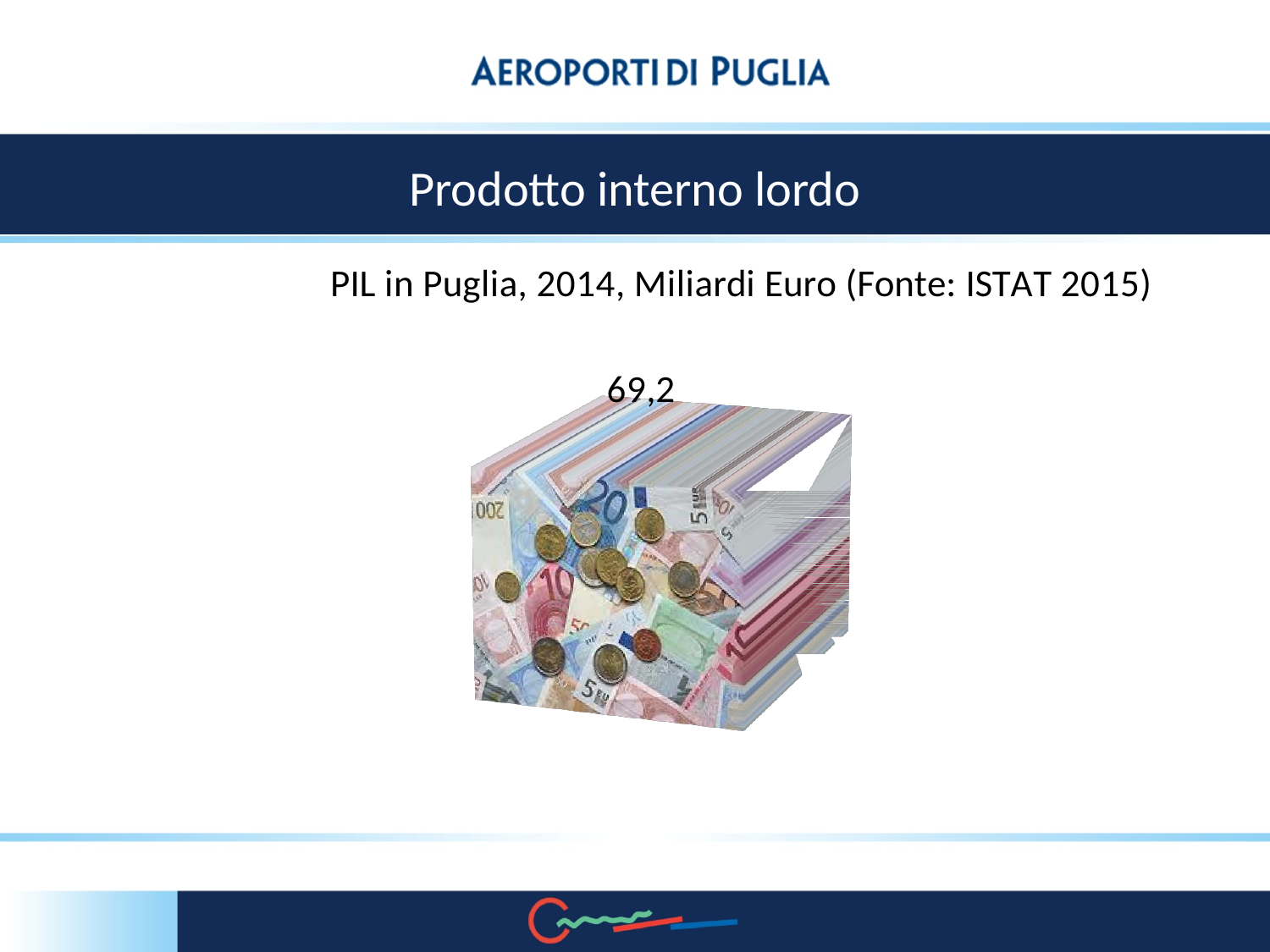
What image is used to fill the bar in the chart? Euro banknotes and coins How many bars does the chart contain? 1 What kind of chart is shown on the slide? bar chart What is the title of the chart? PIL in Puglia, 2014, Miliardi Euro (Fonte: ISTAT 2015) What value is shown by the data label on the bar in the chart? 69,2